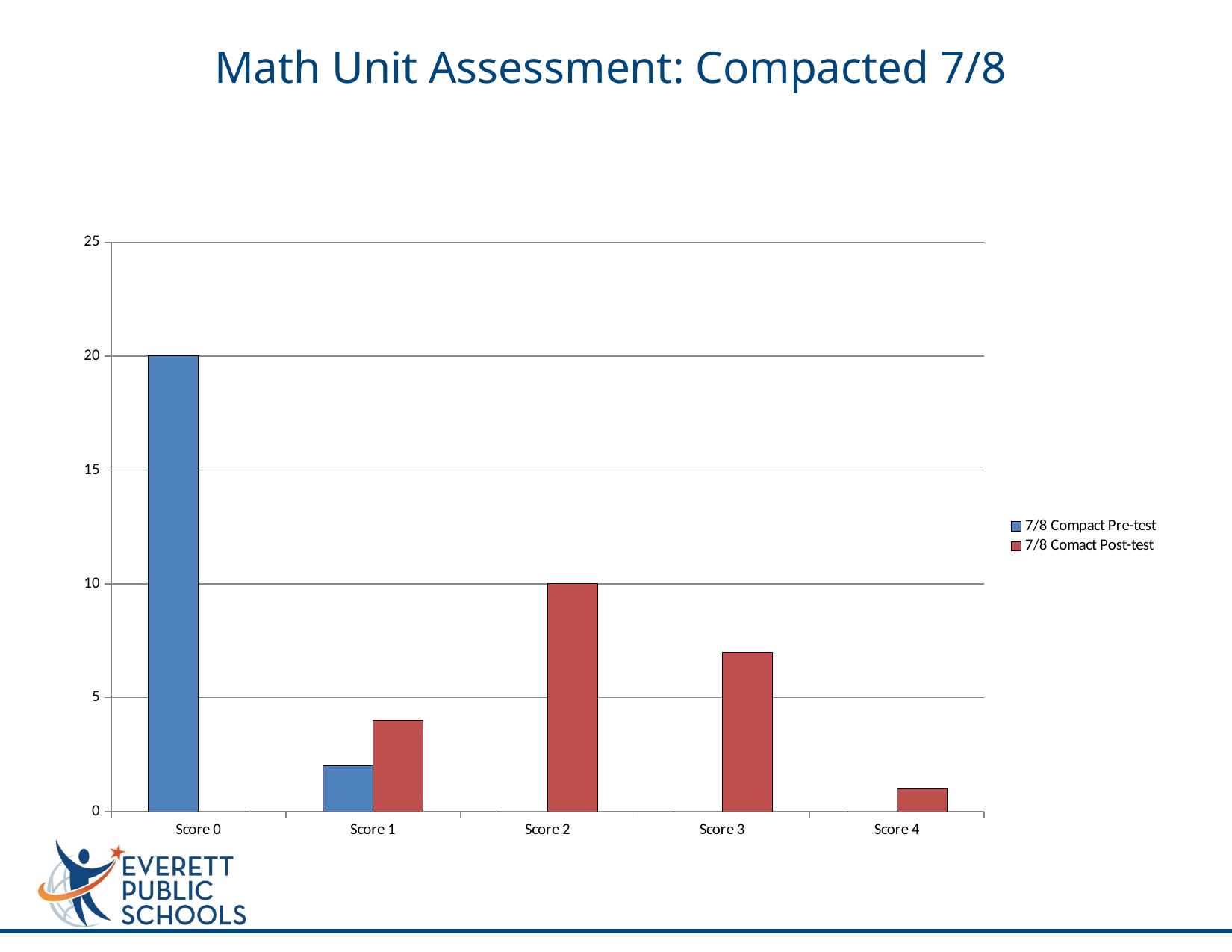
How many series does the legend list? 2 What is the value of the 7/8 Compact Pre-test series for Score 0? 20 What is the difference between the Pre-test value for Score 0 and the Post-test value for Score 2? 10 Is the 7/8 Compact Pre-test value for Score 1 greater or less than 5? less Is the 7/8 Comact Post-test value for Score 1 greater or less than 5? less How many score categories are shown on the x axis? 5 Which score category has the highest value for the 7/8 Comact Post-test series? Score 2 What kind of chart is shown on the slide? bar chart For Score 1, which series has the larger value, the Pre-test or the Post-test? 7/8 Comact Post-test Is the 7/8 Comact Post-test value for Score 3 greater or less than 5? greater What is the value of the 7/8 Comact Post-test series for Score 2? 10 Which score category has the highest value for the 7/8 Compact Pre-test series? Score 0